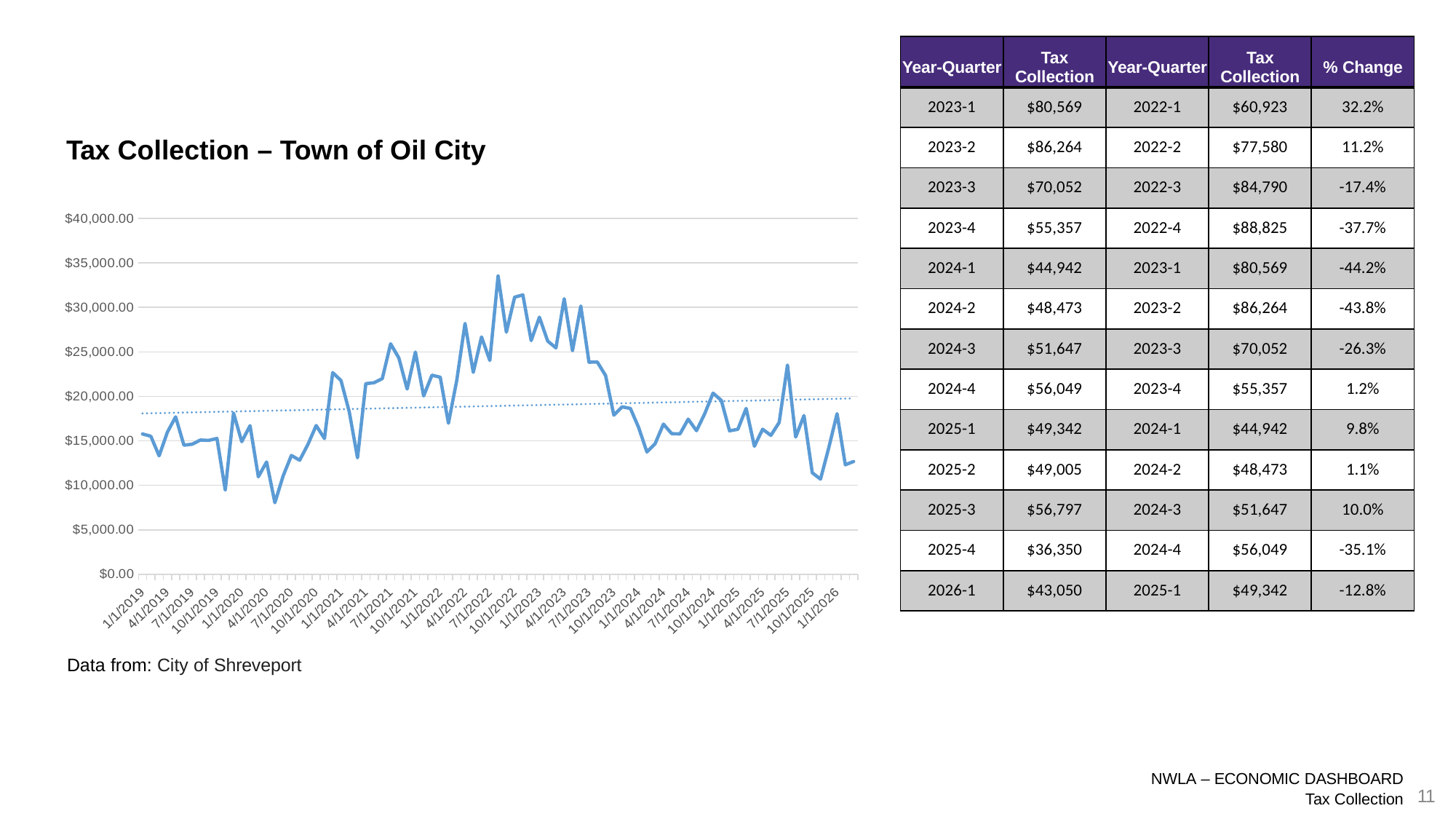
Which is larger, the value for 10/1/2022 or the value for 1/1/2019? 10/1/2022 Is the value for 7/1/2025 greater or less than $20,000.00? greater Does the dotted trendline rise or fall from left to right? rises Is the value for 7/1/2020 greater or less than $10,000.00? greater What is the title of the chart? Tax Collection – Town of Oil City In which year does the line reach its lowest value? 2020 Is the value for 7/1/2022 greater or less than $25,000.00? less According to the note below the chart, where is the data from? City of Shreveport In which year does the line reach its highest value? 2022 What type of chart is shown on the slide? line chart